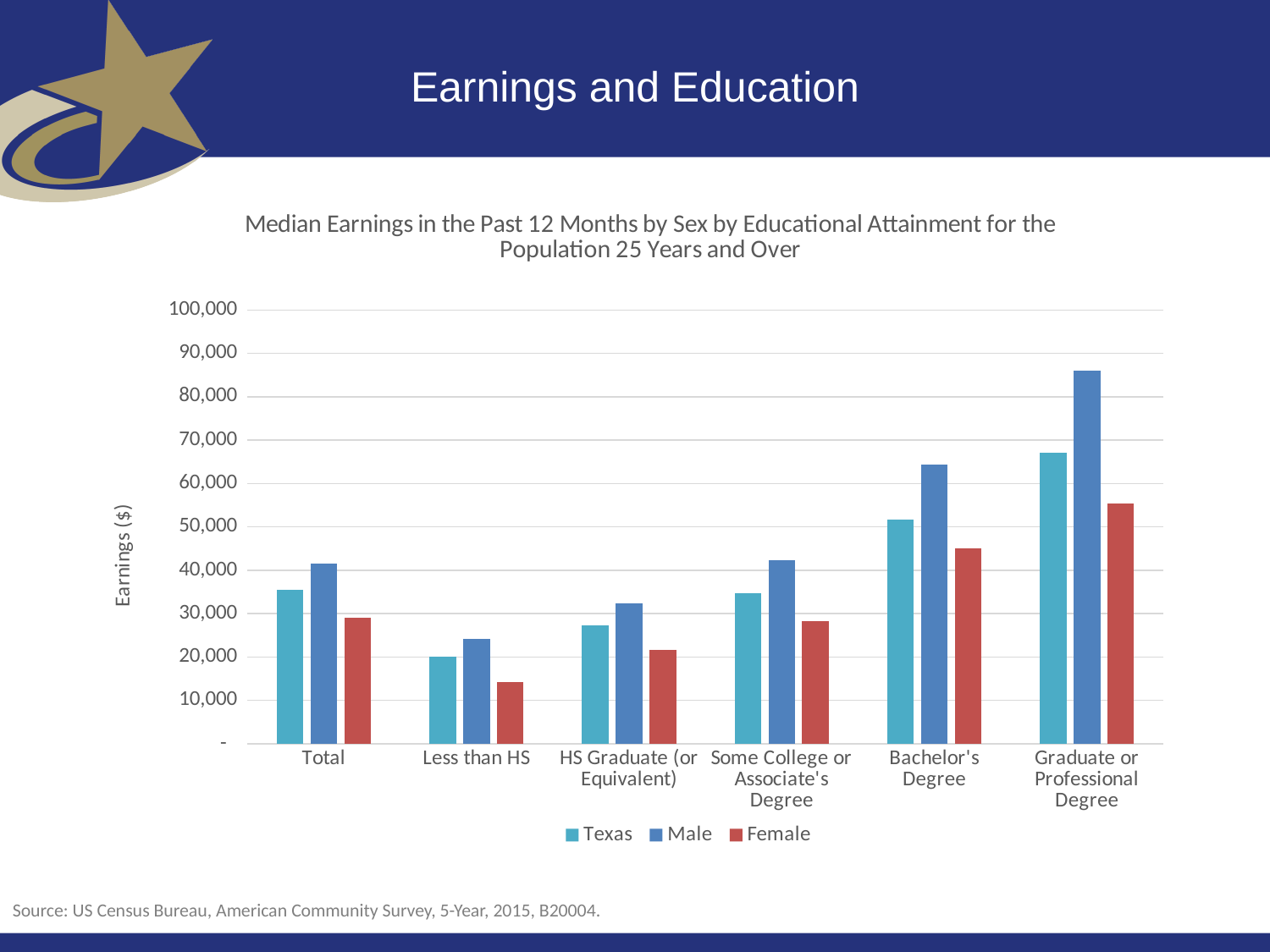
Is the Male value for Graduate or Professional Degree greater or less than 80,000? greater How many educational attainment categories are shown on the x axis? 6 For Bachelor's Degree, which is larger: the Male value or the Female value? Male How many series does the legend list? 3 Is the Male value for Bachelor's Degree greater or less than 60,000? greater Which category has the highest Male median earnings? Graduate or Professional Degree Is the Female value for Graduate or Professional Degree greater or less than 50,000? greater Do the Male median earnings rise or fall moving from Less than HS to Graduate or Professional Degree? rise What kind of chart is shown on the slide? bar chart Which category has the lowest Female median earnings? Less than HS What is the label on the vertical axis of the chart? Earnings ($)